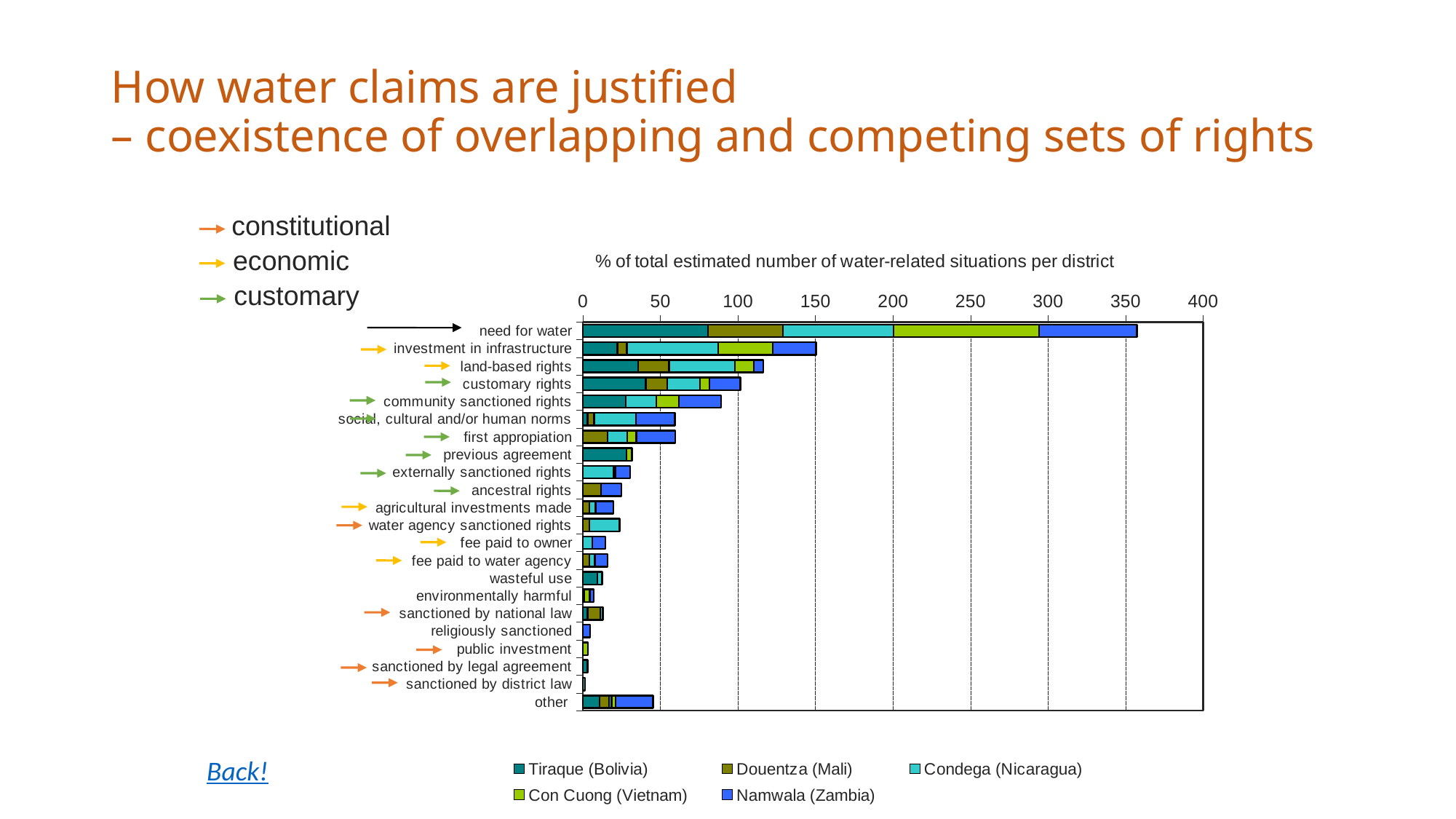
How many categories are plotted on the chart? 22 Which has the larger total bar, land-based rights or community sanctioned rights? land-based rights Is the total value for previous agreement greater or less than 50? less What kind of chart is shown on the slide? bar chart Is the total value for investment in infrastructure greater or less than 100? greater Which category has the shortest total bar? sanctioned by district law Which district is represented by the blue series in the legend? Namwala (Zambia) Is the total value for community sanctioned rights greater or less than 100? less How many series does the chart legend list? 5 What is the axis title shown above the chart? % of total estimated number of water-related situations per district Which category has the longest total bar? need for water